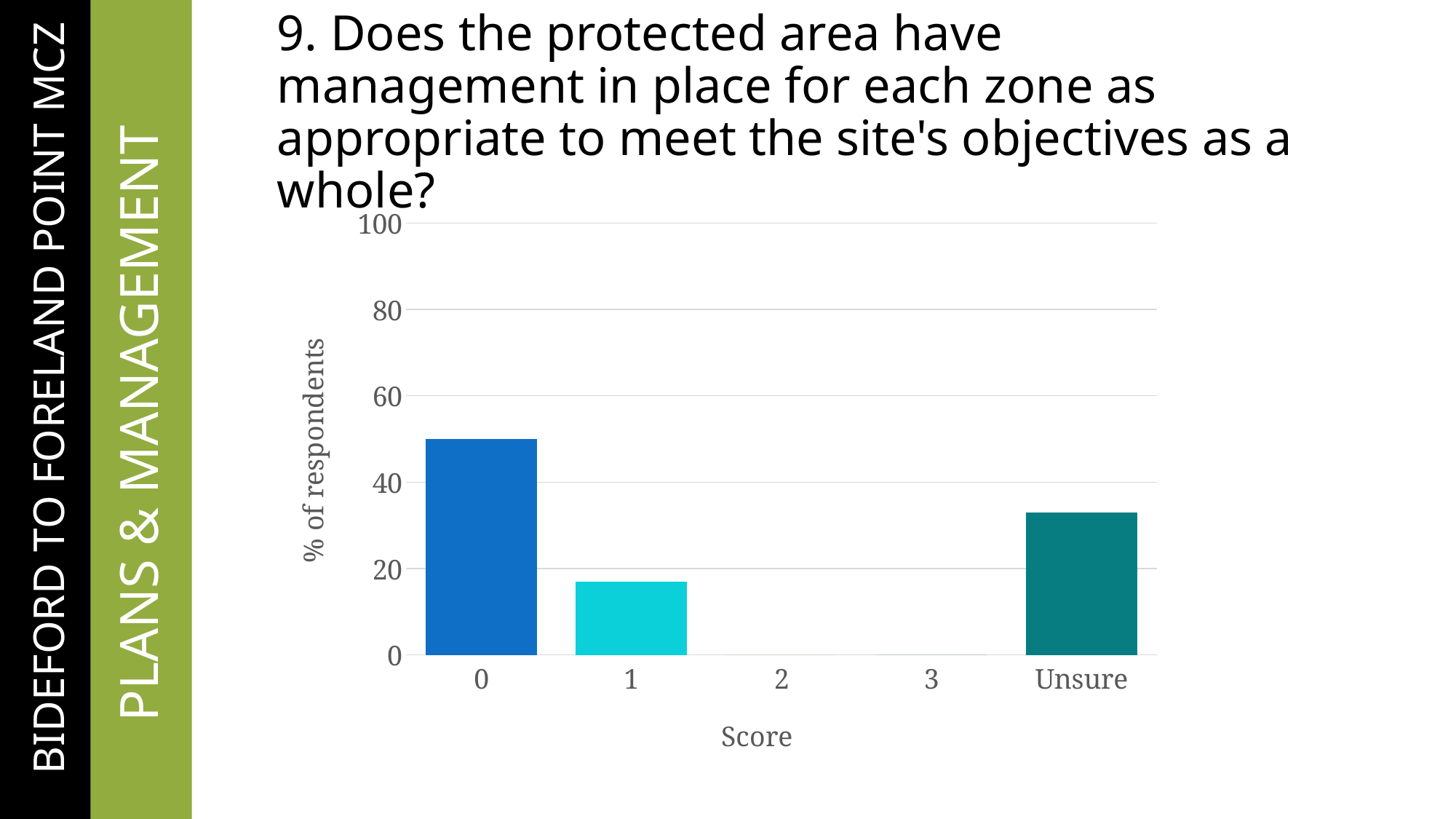
Is the value for score 1 greater or less than 20? less Is the value for Unsure greater or less than 20? greater Which is larger, the value for score 1 or the value for Unsure? Unsure What is the percentage of respondents for score 2? 0 Which is larger, the value for score 0 or the value for Unsure? 0 How many score categories are shown on the x axis? 5 What is the label of the x axis? Score What is the label of the y axis? % of respondents What kind of chart is shown on the slide? bar chart Is the value for Unsure greater or less than 40? less Which score category has the highest percentage of respondents? 0